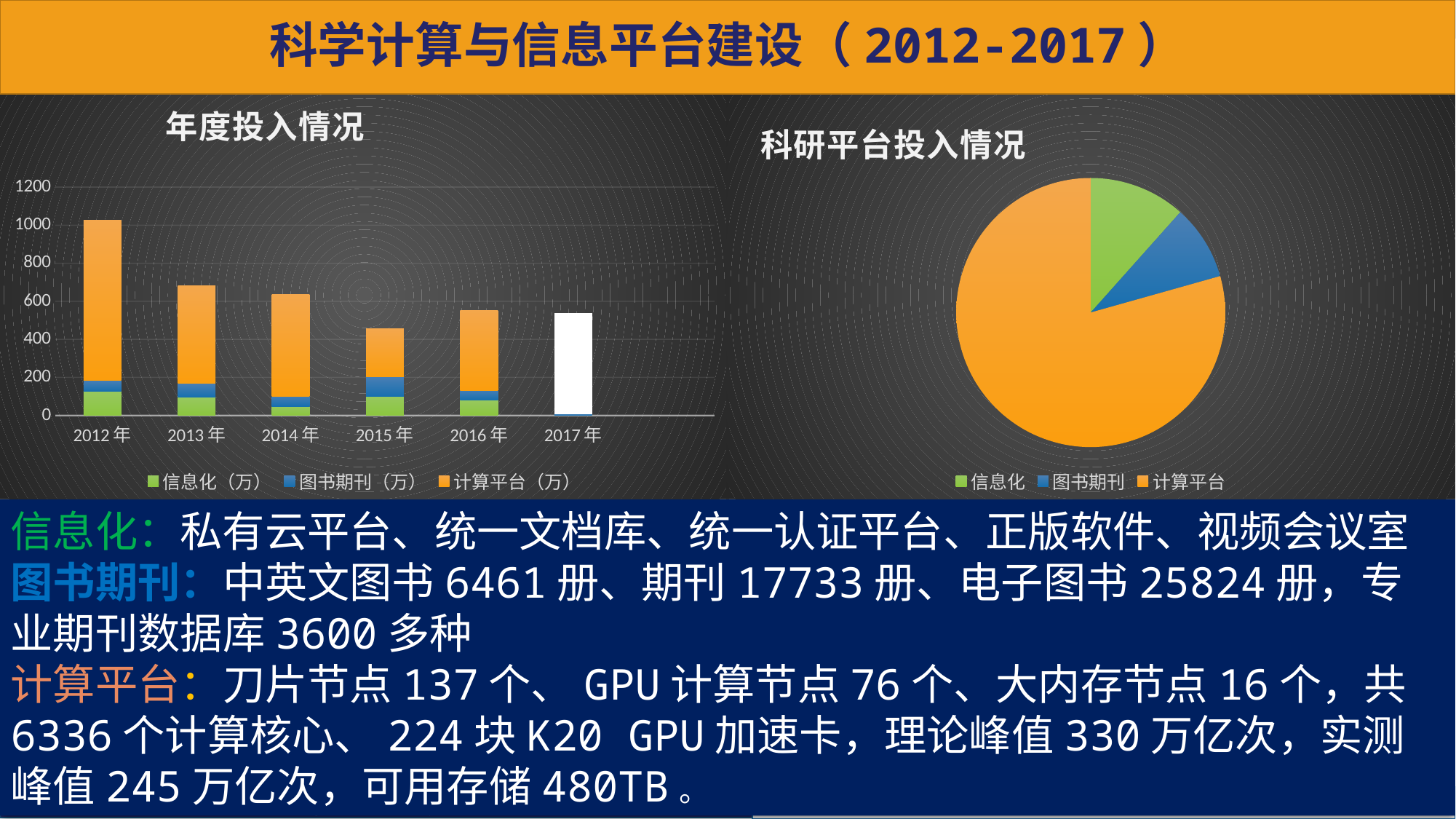
In the 年度投入情况 chart, how many series does the legend list? 3 In the 年度投入情况 chart, how many years are shown on the x axis? 6 What kind of chart is the 年度投入情况 chart on the left? bar chart In the 年度投入情况 chart, is the total for 2012年 greater or less than 1000? greater In the 年度投入情况 chart, is the total for 2015年 greater or less than 600? less What kind of chart is the 科研平台投入情况 chart on the right? pie chart In the 科研平台投入情况 pie chart, which category has the largest slice? 计算平台 In the 年度投入情况 chart, which total is larger, 2012年 or 2013年? 2012年 In the 年度投入情况 chart, is the total for 2013年 greater or less than 600? greater In the 年度投入情况 chart, which year has the highest total bar? 2012年 In the 年度投入情况 chart, which year has the lowest total bar? 2015年 In the 科研平台投入情况 pie chart, how many slices are there? 3